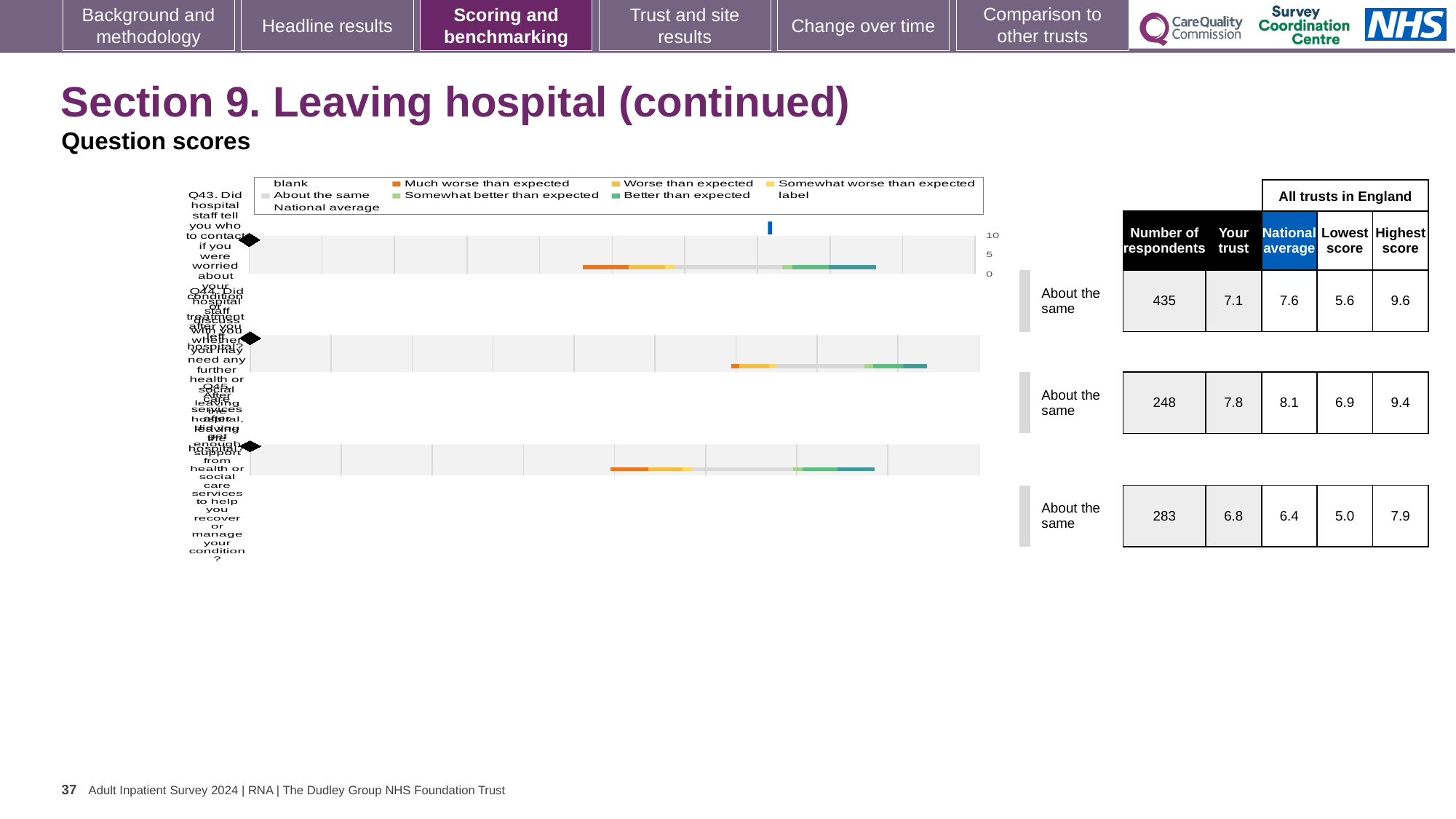
For Q45, which is larger: the 'Your trust' score or the national average? Your trust What is the national average score for Q44? 8.1 What is the 'Your trust' score for Q43? 7.1 What kind of chart is shown on the slide? bar chart Which question has the lowest number of respondents? Q44 Which question has the highest 'Your trust' score? Q44 How many respondents are listed for Q45? 283 Is the 'Your trust' score for Q43 greater or less than 5? greater How many questions (bars) are plotted in the chart? 3 What is the highest value shown on the chart's axis? 10 What colour does the legend use for 'Much worse than expected'? orange What is the difference between the highest score and the lowest score for Q43? 4.0